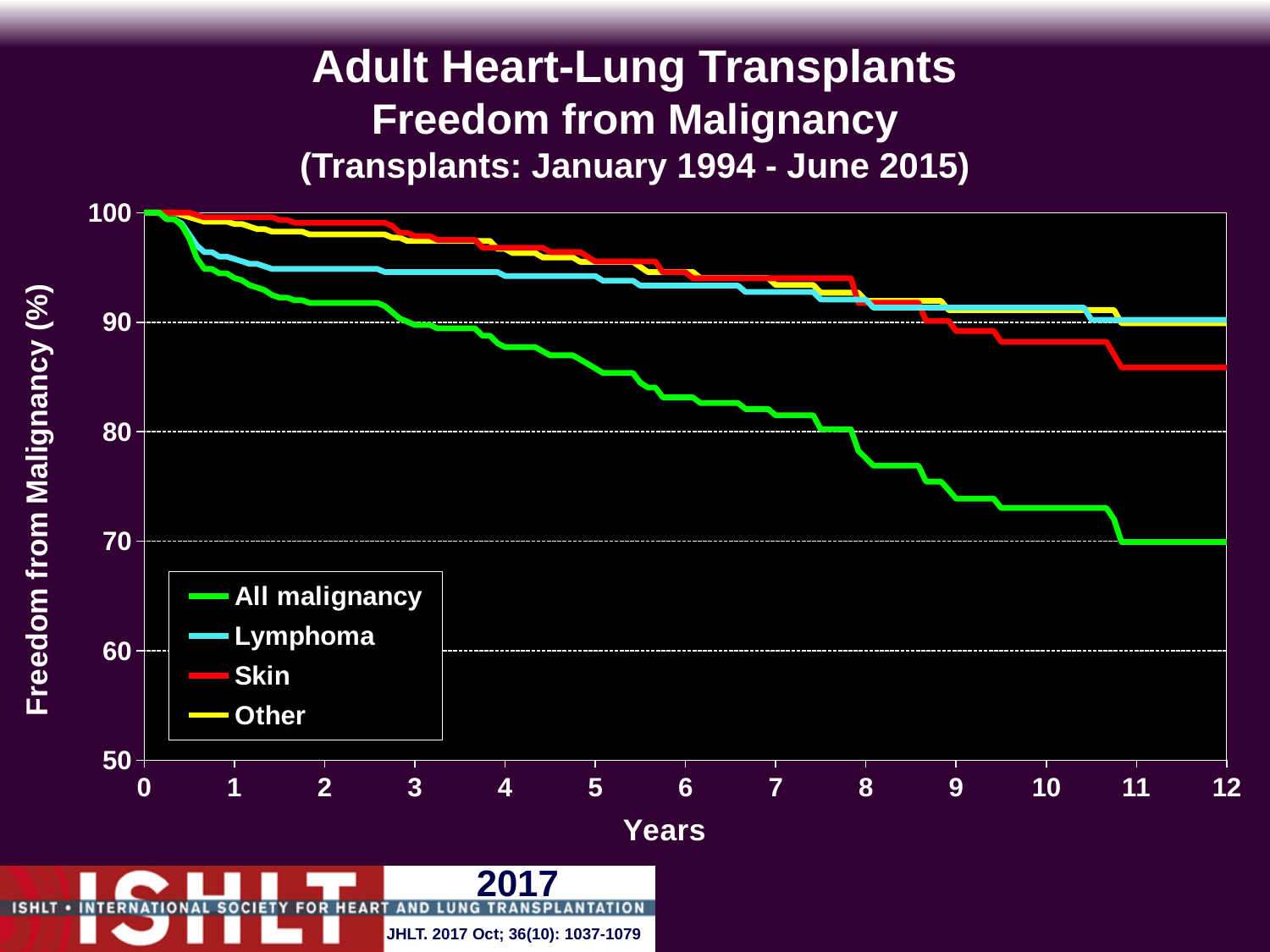
Is the value for All malignancy at 10 years greater or less than 80? less Is the value for Lymphoma at 6 years greater or less than 90? greater What kind of chart is shown on the slide? line chart Which series is the lowest at 12 years? All malignancy At 2 years, which is higher: Skin or Lymphoma? Skin What is the value of all series at 0 years? 100 How many series does the legend list? 4 Is the value for Skin at 12 years greater or less than 80? greater What is the label of the y axis? Freedom from Malignancy (%) At 12 years, which is higher: Skin or All malignancy? Skin Does the All malignancy line rise or fall as years increase? fall